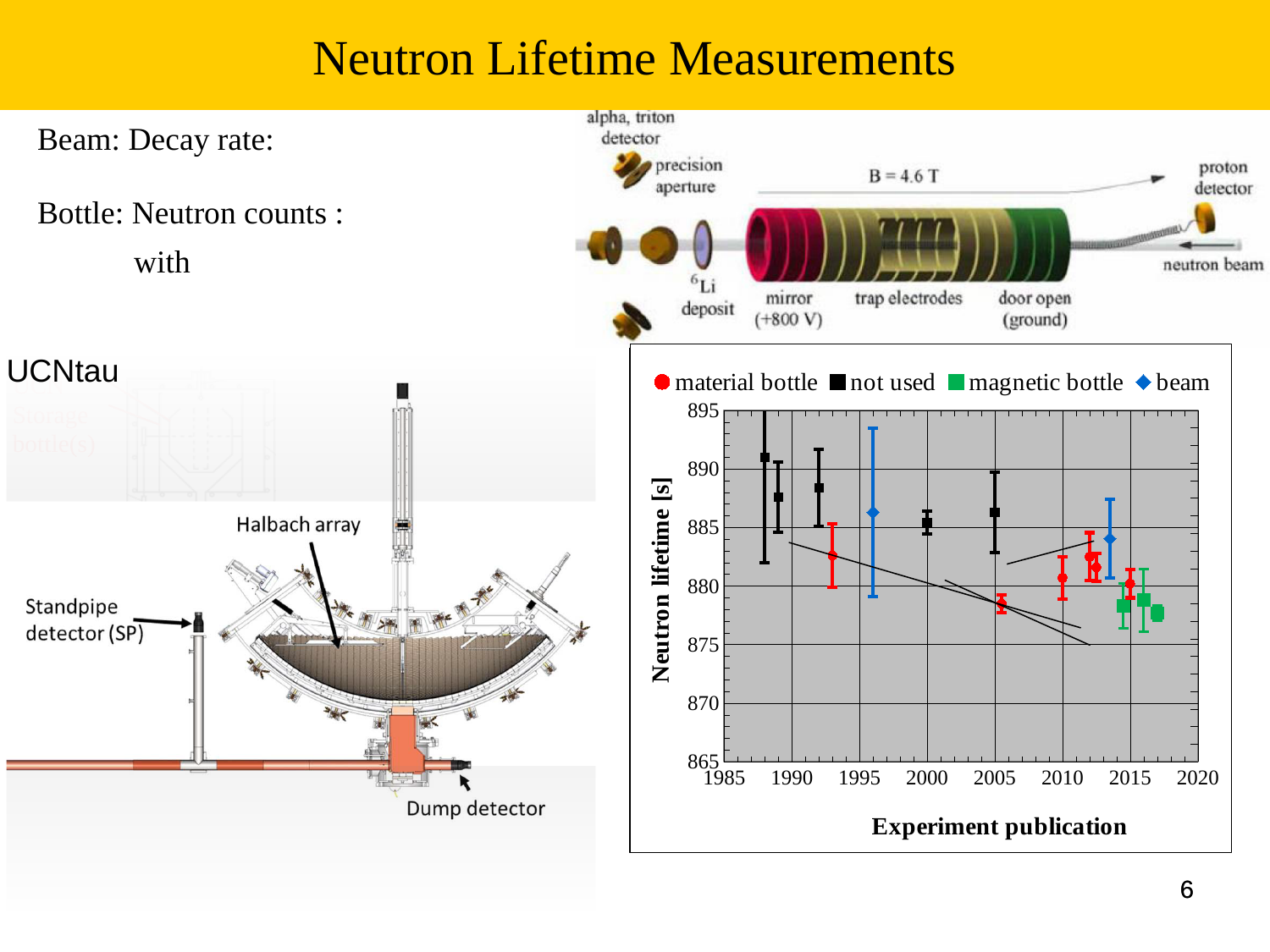
In the neutron lifetime chart, are the 'magnetic bottle' values greater or less than 880? less How many series does the legend of the neutron lifetime chart list? 4 In the neutron lifetime chart, which series is plotted with green squares? magnetic bottle In the neutron lifetime chart, which is larger: the 'beam' value published around 1996 or the 'magnetic bottle' value published around 2015? beam (1996) In the neutron lifetime chart, which series contains the highest plotted lifetime value? not used What is the label of the vertical axis of the neutron lifetime chart? Neutron lifetime [s] What is the label of the horizontal axis of the neutron lifetime chart? Experiment publication In the neutron lifetime chart, is the 'material bottle' value published around 2005 greater or less than 880? less In the neutron lifetime chart, is the 'not used' value published around 1989 greater or less than 885? greater How many 'beam' data points are plotted in the neutron lifetime chart? 2 In the neutron lifetime chart, do the measured lifetimes generally rise or fall with publication year? fall What kind of chart is the neutron lifetime plot? Scatter plot with error bars